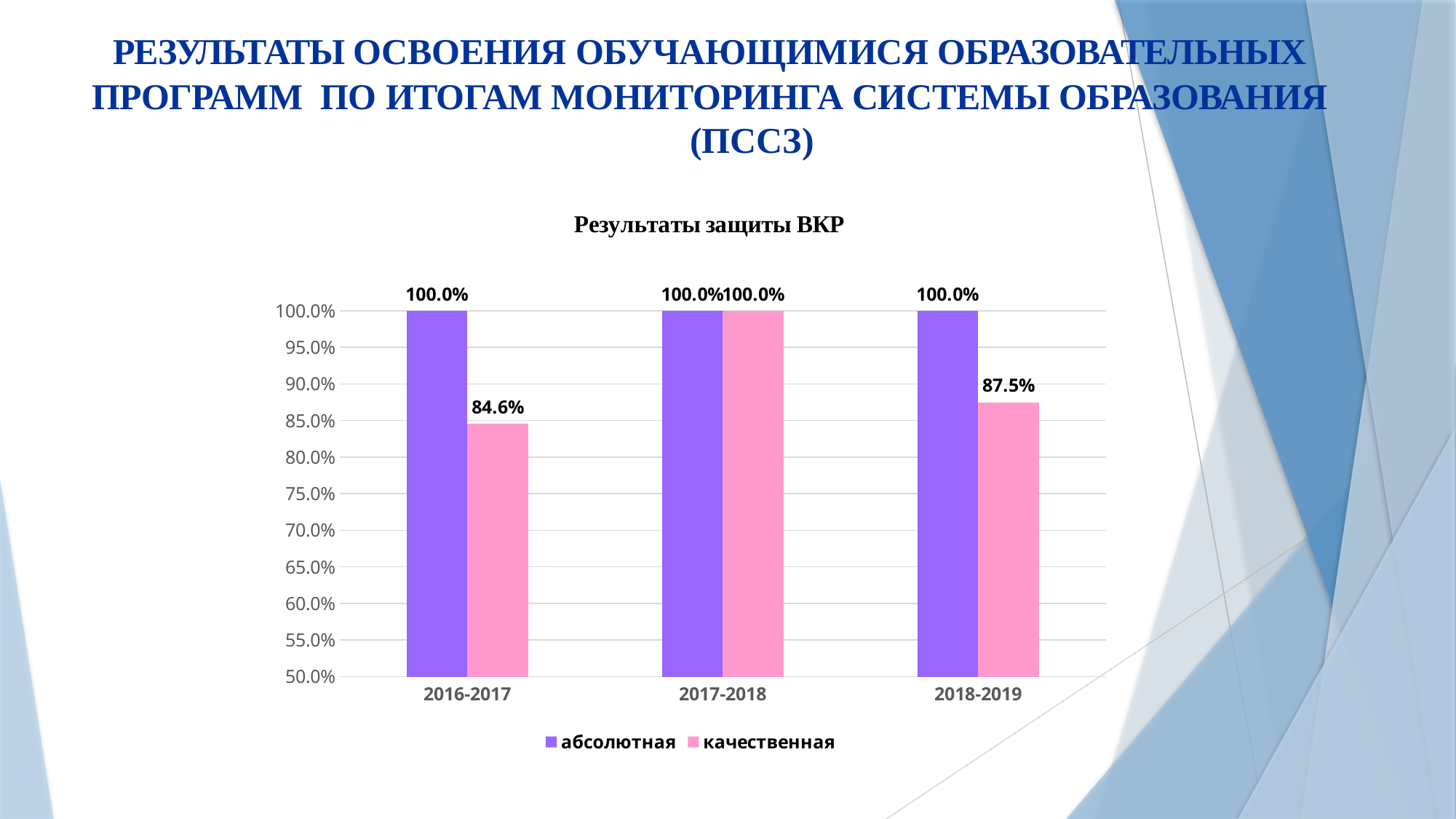
What is the difference between абсолютная and качественная in 2018-2019? 12.5% How many academic years are shown on the x axis? 3 How many series does the legend list? 2 What is the value of качественная for 2018-2019? 87.5% What is the value of качественная for 2016-2017? 84.6% What type of chart is shown on the slide? Bar chart Is the качественная value for 2016-2017 greater or less than 90.0%? less What is the value of абсолютная for 2017-2018? 100.0% What is the value of качественная for 2017-2018? 100.0% In which year is the качественная value lowest? 2016-2017 What is the difference between the качественная values for 2018-2019 and 2016-2017? 2.9% Which is larger in 2016-2017, абсолютная or качественная? абсолютная